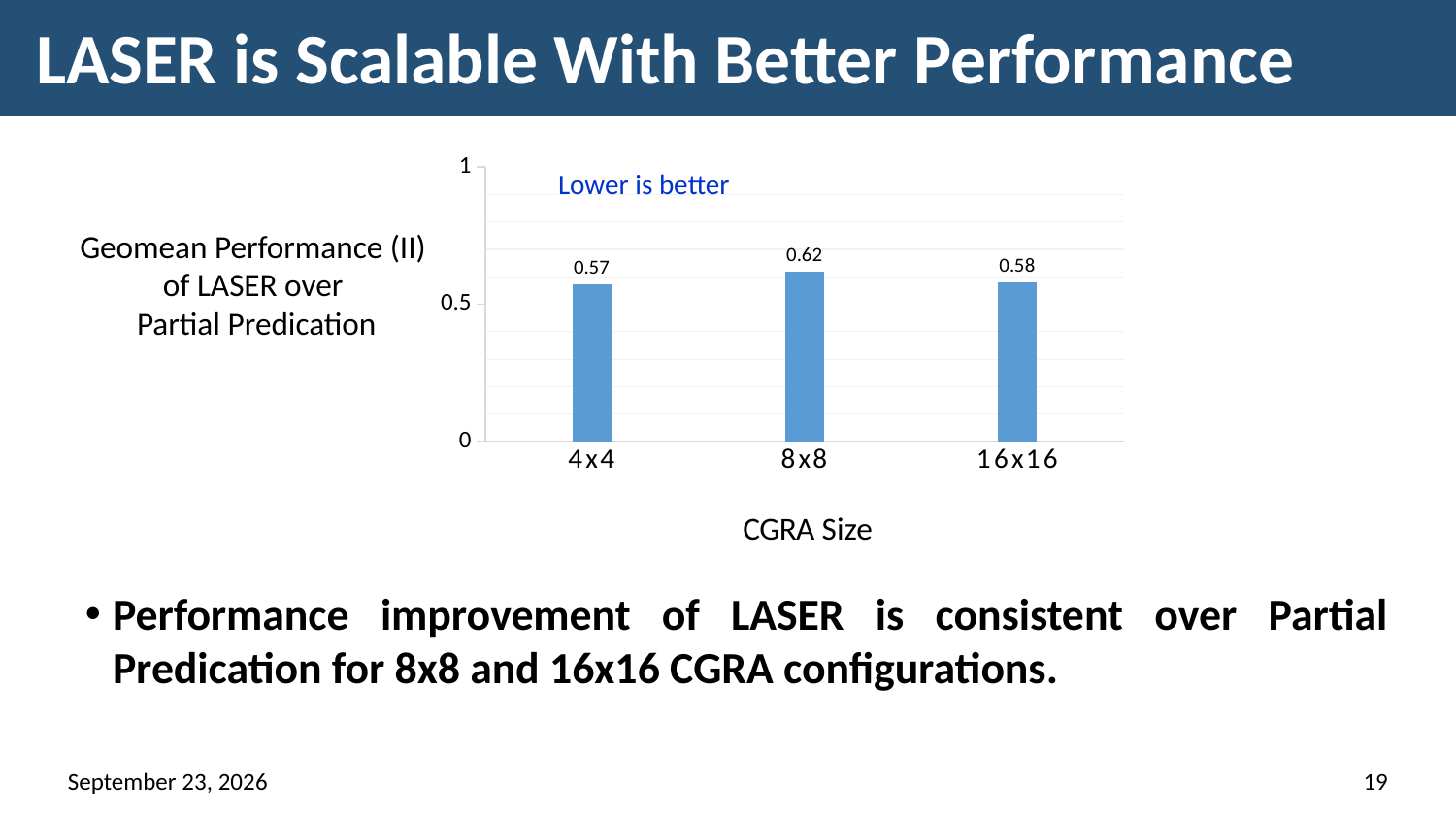
What is the geomean performance value for the 4x4 CGRA size? 0.57 Which CGRA size has the highest value? 8x8 What is the geomean performance value for the 8x8 CGRA size? 0.62 What is the label of the x axis? CGRA Size Which CGRA size has the lowest value? 4x4 What kind of chart is shown on the slide? bar chart How many CGRA sizes are shown on the x axis? 3 Which has a larger value, 8x8 or 16x16? 8x8 What is the difference between the values for 8x8 and 4x4? 0.05 What is the difference between the values for 8x8 and 16x16? 0.04 What is the geomean performance value for the 16x16 CGRA size? 0.58 Is the value for 8x8 greater or less than 0.5? greater